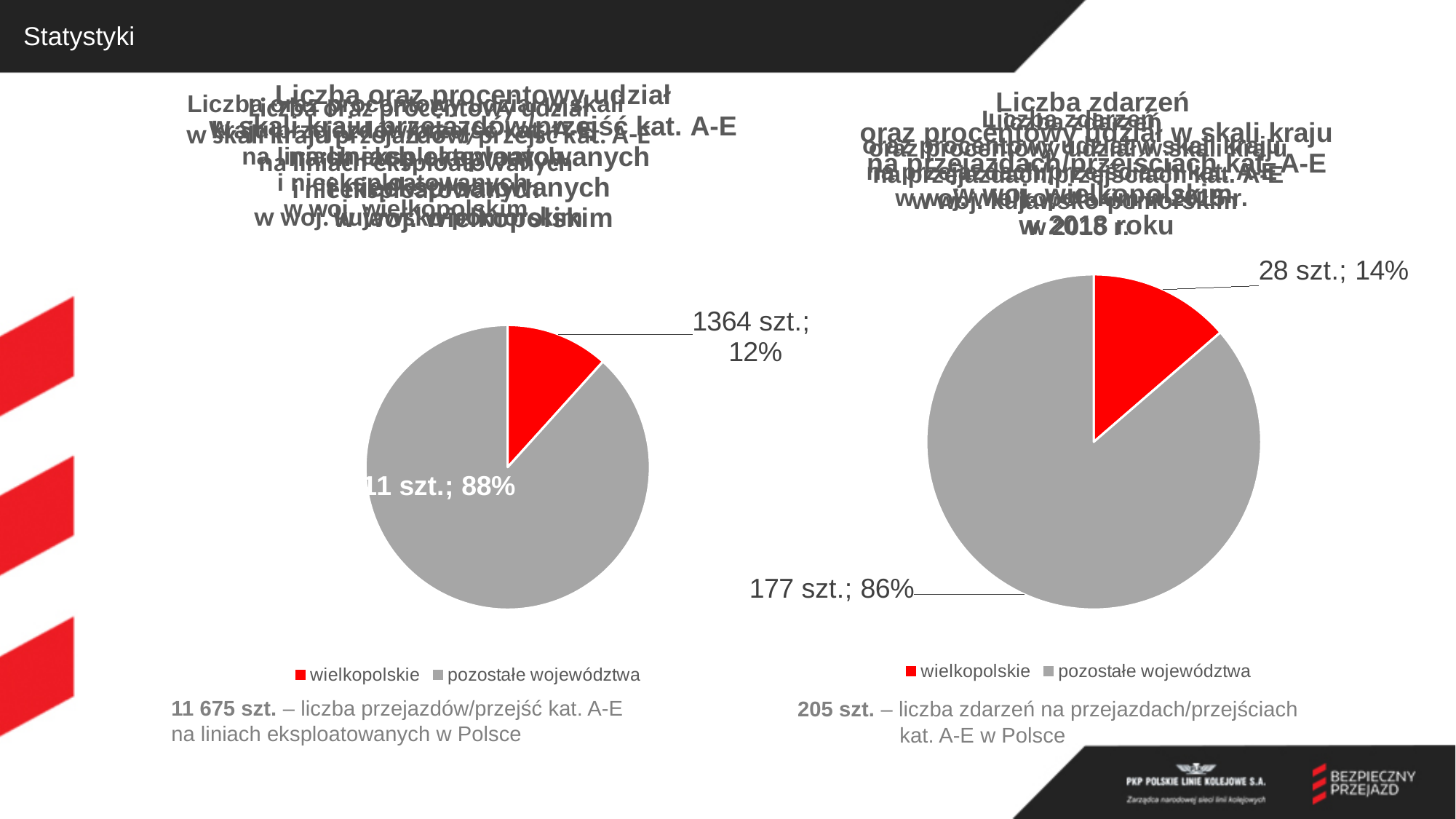
In the right pie chart, which slice is larger: wielkopolskie or pozostałe województwa? pozostałe województwa In the right pie chart, what is the total of the two slices? 205 szt. In the left pie chart, what is the value shown for wielkopolskie? 1364 szt. In the left pie chart, what percentage share does wielkopolskie have? 12% In the right pie chart, what percentage share does wielkopolskie have? 14% In the right pie chart, what is the difference between the values for pozostałe województwa and wielkopolskie? 149 szt. How many entries does the legend of the left pie chart list? 2 In the left pie chart, what percentage share do pozostałe województwa have? 88% In the left pie chart, what colour is the wielkopolskie slice? red In the right pie chart, what is the value shown for pozostałe województwa? 177 szt. What kind of chart is the chart on the left of the slide? pie chart In the right pie chart, what is the value shown for wielkopolskie? 28 szt.